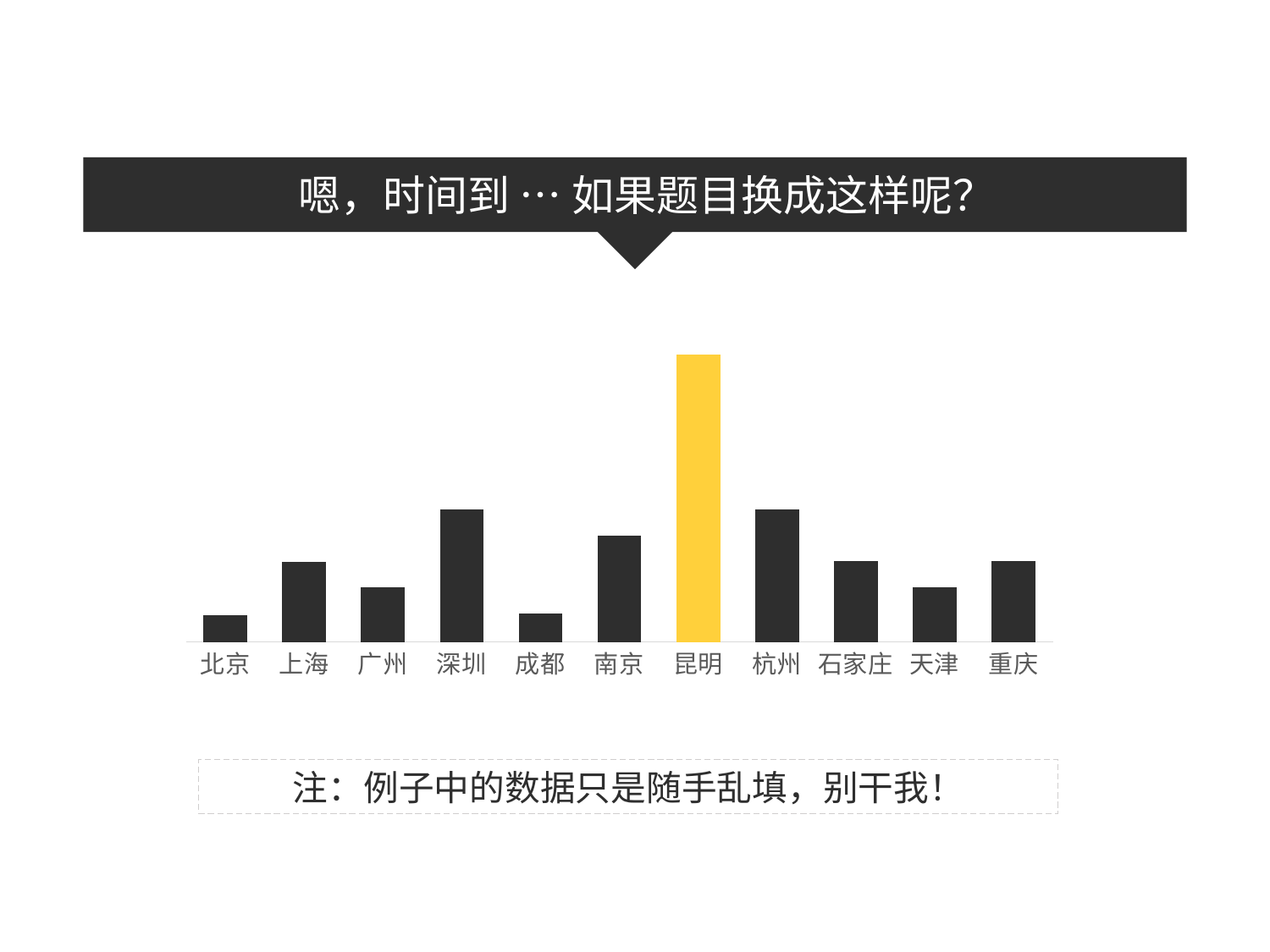
Which bar is higher, 深圳 or 北京? 深圳 Which bar is higher, 昆明 or 杭州? 昆明 Which city has the highest bar in the chart? 昆明 Which bar is higher, 重庆 or 天津? 重庆 How many cities are shown on the x axis of the chart? 11 Which city's bar is highlighted in yellow? 昆明 What kind of chart is shown on the slide? bar chart How many bars in the chart are coloured yellow rather than dark grey? 1